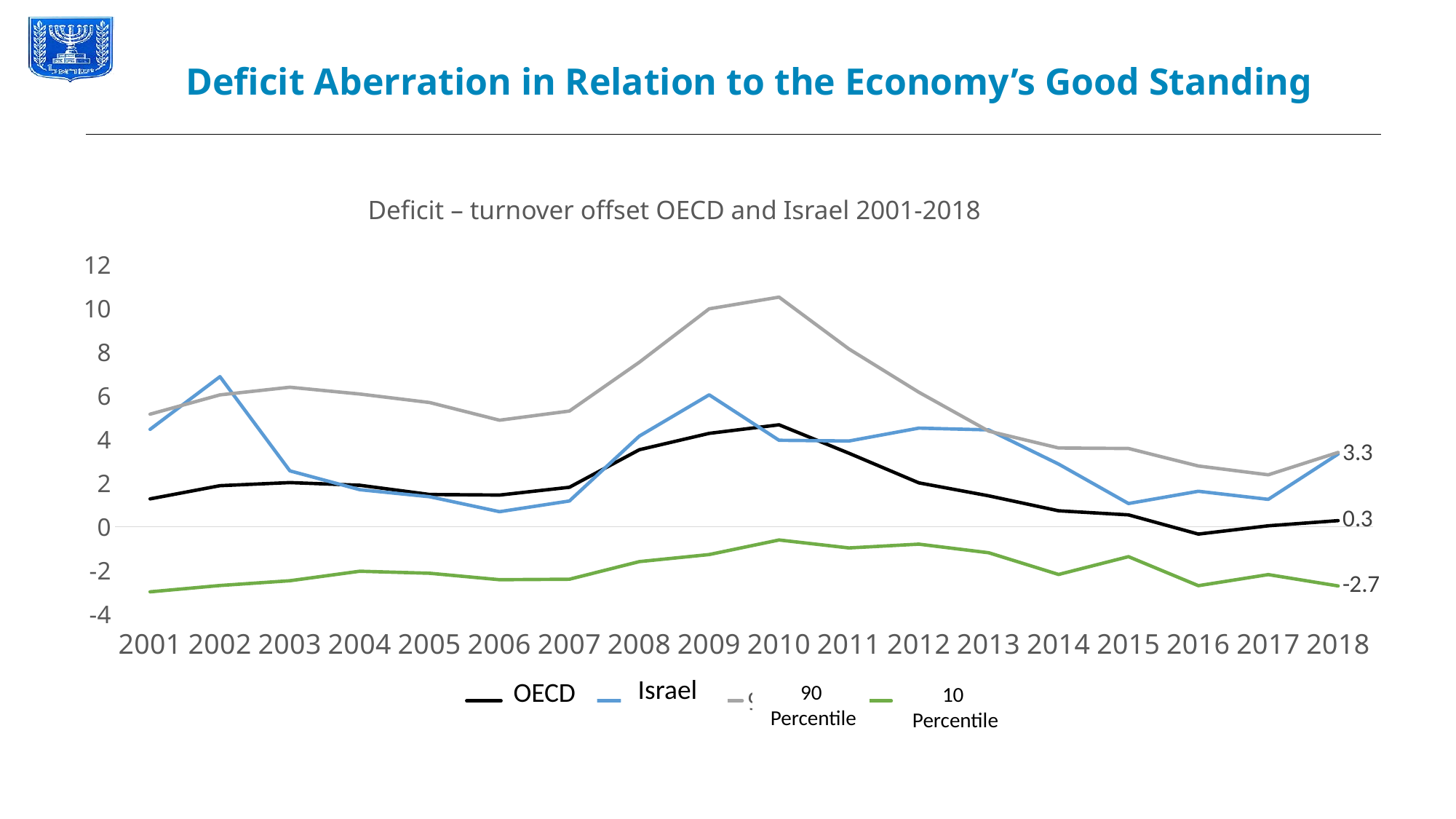
Is the value for Israel in 2002 greater or less than 6? greater Is the value for the 90 Percentile series in 2010 greater or less than 10? greater In which year does the 90 Percentile series reach its highest value? 2010 What is the difference between the OECD value and the 10 Percentile value in 2018? 3.0 What is the value for OECD in 2018? 0.3 What is the title of the chart? Deficit – turnover offset OECD and Israel 2001-2018 What is the value for the 10 Percentile series in 2018? -2.7 How many series does the legend list? 4 How many years are shown on the x axis? 18 What kind of chart is shown on the slide? line chart In 2002, which is higher, Israel or OECD? Israel Does the 90 Percentile series rise or fall from 2010 to 2018? fall